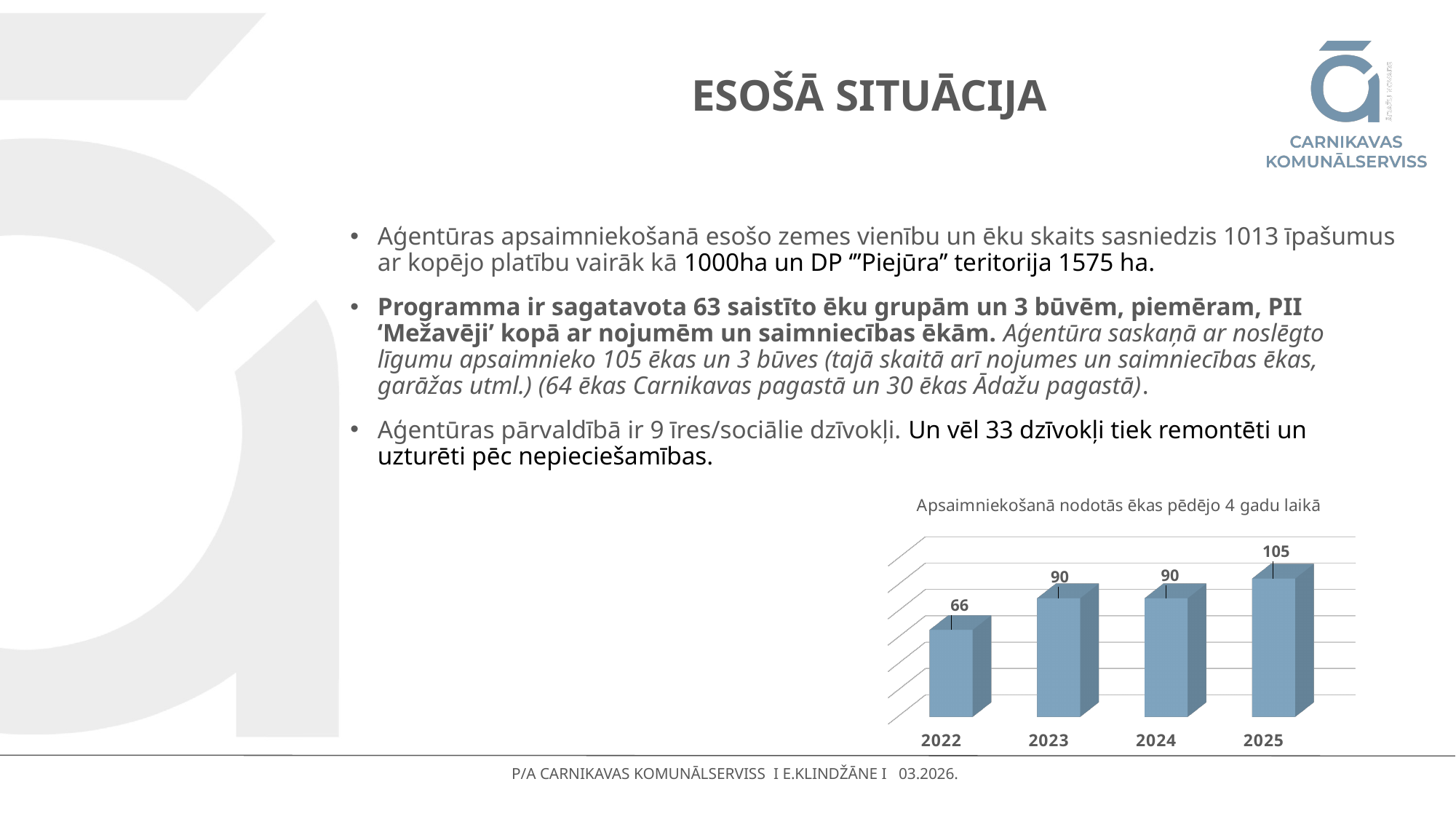
Do the values rise or fall from 2022 to 2025? rise What is the value for 2023? 90 Which year has the lowest value? 2022 What kind of chart is shown on the slide? bar chart Which is larger, the value for 2024 or the value for 2025? 2025 Which year has the highest value? 2025 What is the title of the chart? Apsaimniekošanā nodotās ēkas pēdējo 4 gadu laikā What is the difference between the values for 2025 and 2022? 39 How many years are shown on the x axis? 4 What is the difference between the values for 2023 and 2022? 24 What is the value for 2025? 105 What is the value for 2022? 66